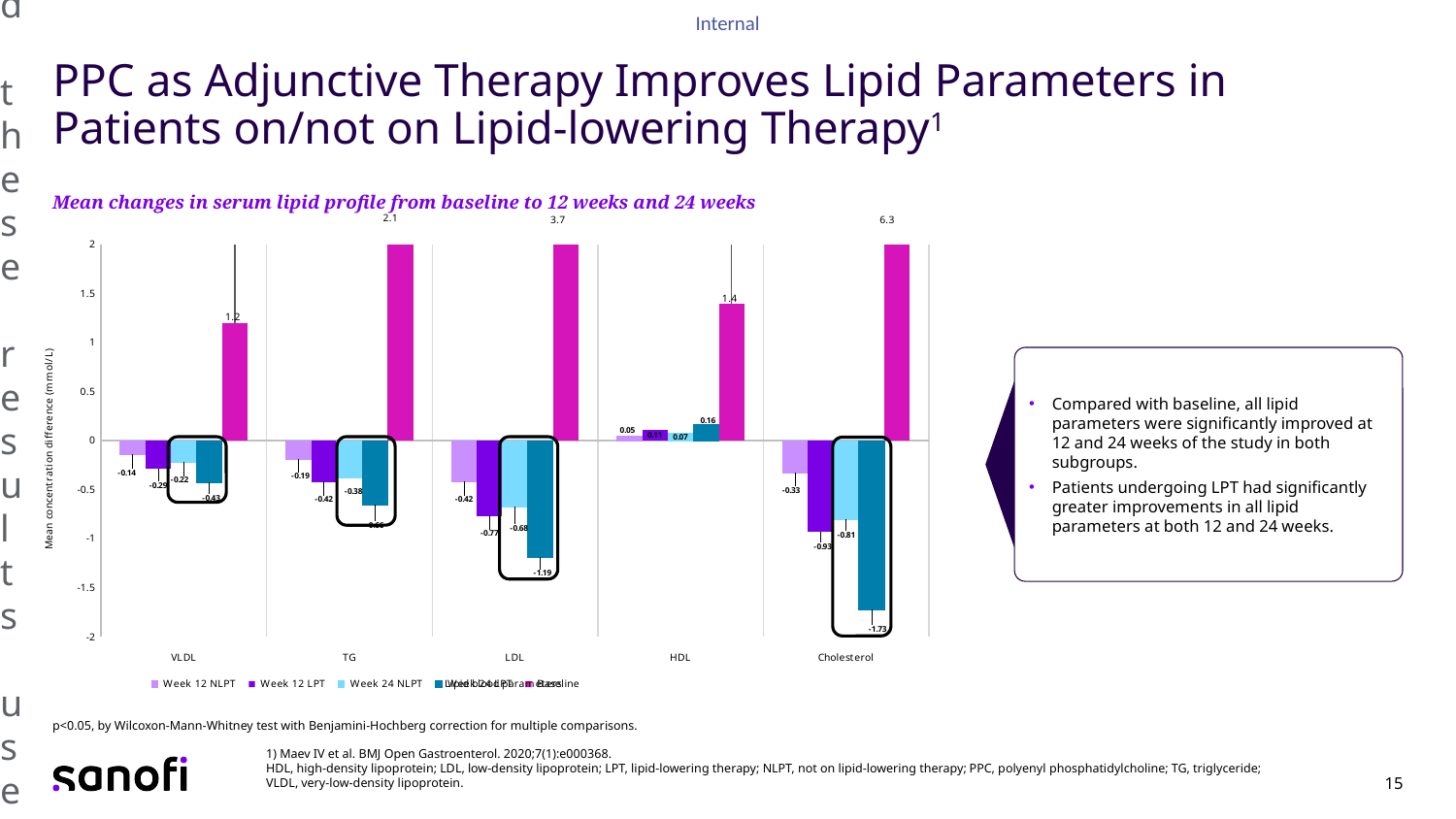
What is the difference between the Week 12 NLPT value (-0.42) and the Week 12 LPT value (-0.77) for LDL? 0.35 Which category has the lowest Week 24 LPT value? Cholesterol What is the label of the y axis of the chart? Mean concentration difference (mmol/L) Which category has the highest Baseline value? Cholesterol What is the Baseline value for Cholesterol? 6.3 What is the Week 12 NLPT value for VLDL? -0.14 What is the Week 24 LPT value for Cholesterol? -1.73 For HDL, which is larger: the Week 12 LPT value or the Week 24 LPT value? Week 24 LPT What kind of chart is shown on the slide? Bar chart How many lipid parameter categories are shown on the x axis of the chart? 5 What is the Baseline value for TG? 2.1 What is the Week 24 LPT value for LDL? -1.19